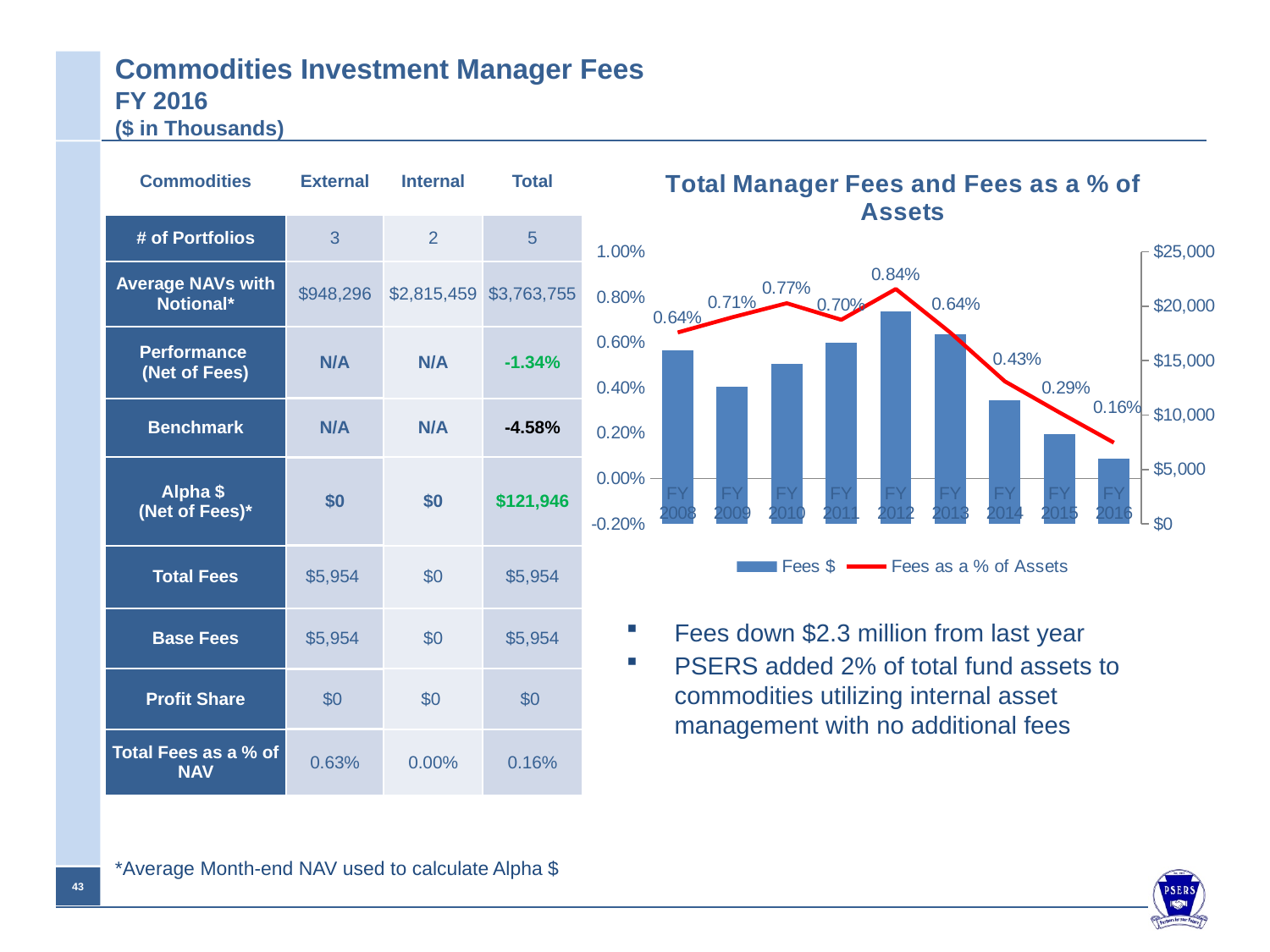
Is the Fees $ value for FY 2016 greater or less than $10,000? less Which is larger, Fees as a % of Assets in FY 2010 or in FY 2011? FY 2010 How many series does the chart legend list? 2 What is the value of Fees as a % of Assets for FY 2008? 0.64% What is the value of Fees as a % of Assets for FY 2016? 0.16% Is the Fees $ value for FY 2012 greater or less than $15,000? greater What is the difference between Fees as a % of Assets in FY 2012 and FY 2016? 0.68% How many fiscal years are shown on the x axis of the chart? 9 In which fiscal year is Fees as a % of Assets lowest? FY 2016 Which fiscal year has the tallest Fees $ bar? FY 2012 In which fiscal year is Fees as a % of Assets highest? FY 2012 What is the value of Fees as a % of Assets for FY 2012? 0.84%